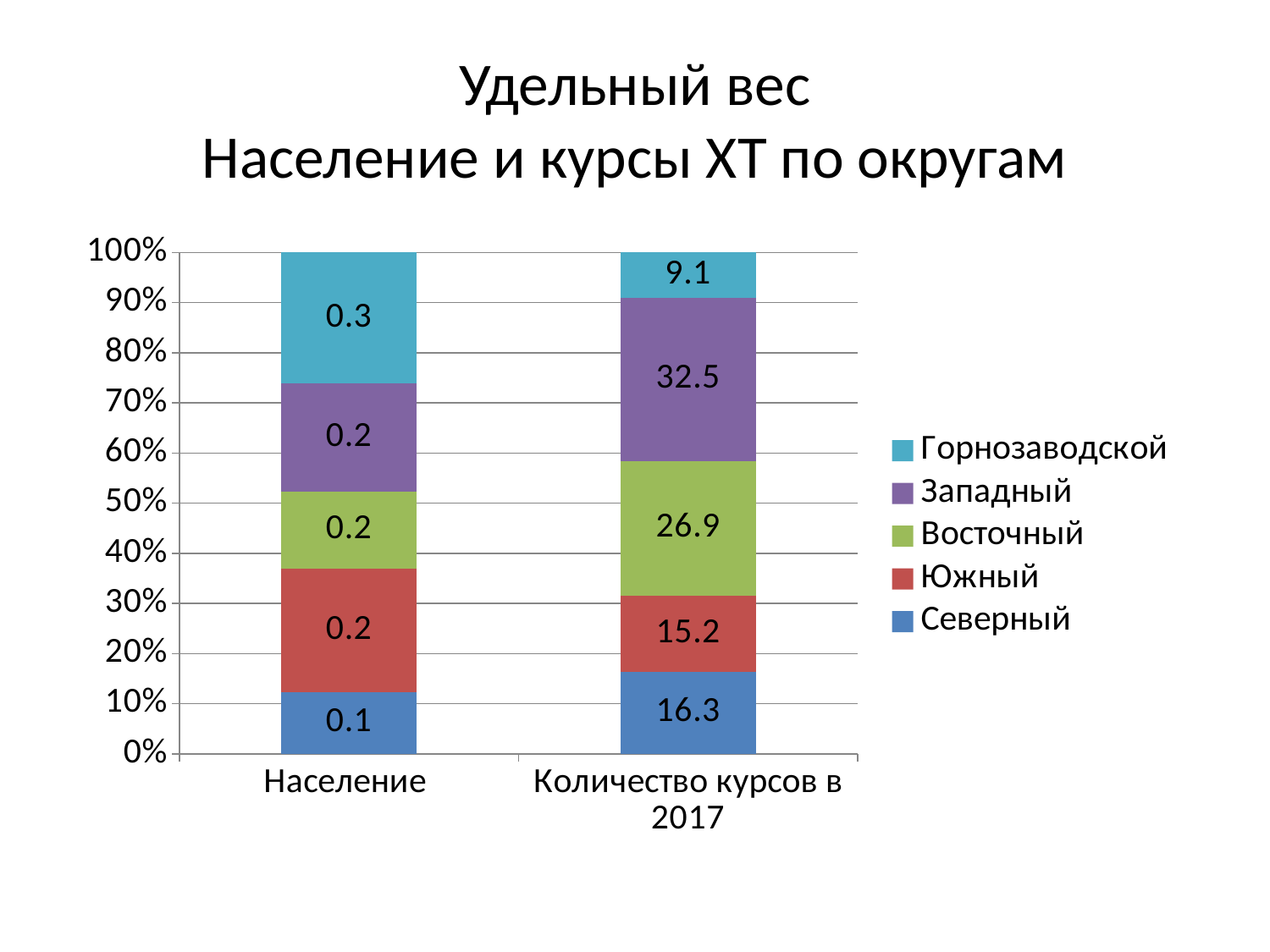
How many categories are shown on the x axis? 2 What kind of chart is shown on the slide? Stacked bar chart What is the value for Северный in the Население bar? 0.1 What is the value for Западный in the Количество курсов в 2017 bar? 32.5 What is the value for Северный in the Количество курсов в 2017 bar? 16.3 Which series has the largest value in the Количество курсов в 2017 bar? Западный What is the value for Горнозаводской in the Население bar? 0.3 What is the title of the chart? Удельный вес Население и курсы ХТ по округам How many series does the legend list? 5 In the Количество курсов в 2017 bar, which is larger: Северный or Южный? Северный Which series has the smallest value in the Количество курсов в 2017 bar? Горнозаводской What is the difference between the Восточный and Южный values in the Количество курсов в 2017 bar? 11.7